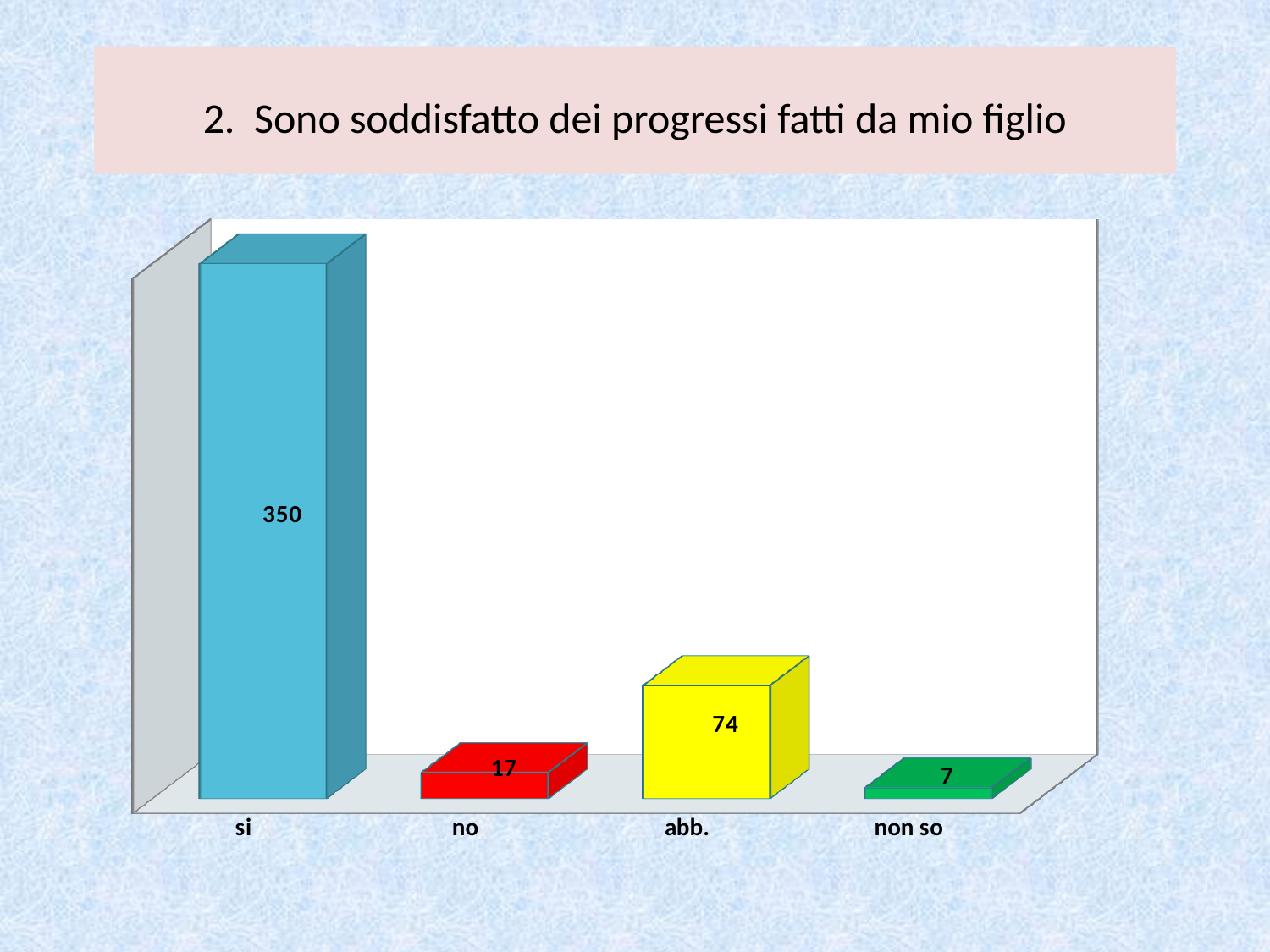
What is the value for "non so"? 7 Which is larger, the value for "no" or the value for "abb."? abb. What is the difference between the values for "no" and "non so"? 10 What is the value for "si"? 350 What is the value for "no"? 17 How many categories are shown in the chart? 4 What is the difference between the values for "si" and "abb."? 276 Which category has the lowest value? non so What colour is the bar for "abb."? yellow Which category has the highest value? si What kind of chart is shown on the slide? bar chart What is the value for "abb."? 74